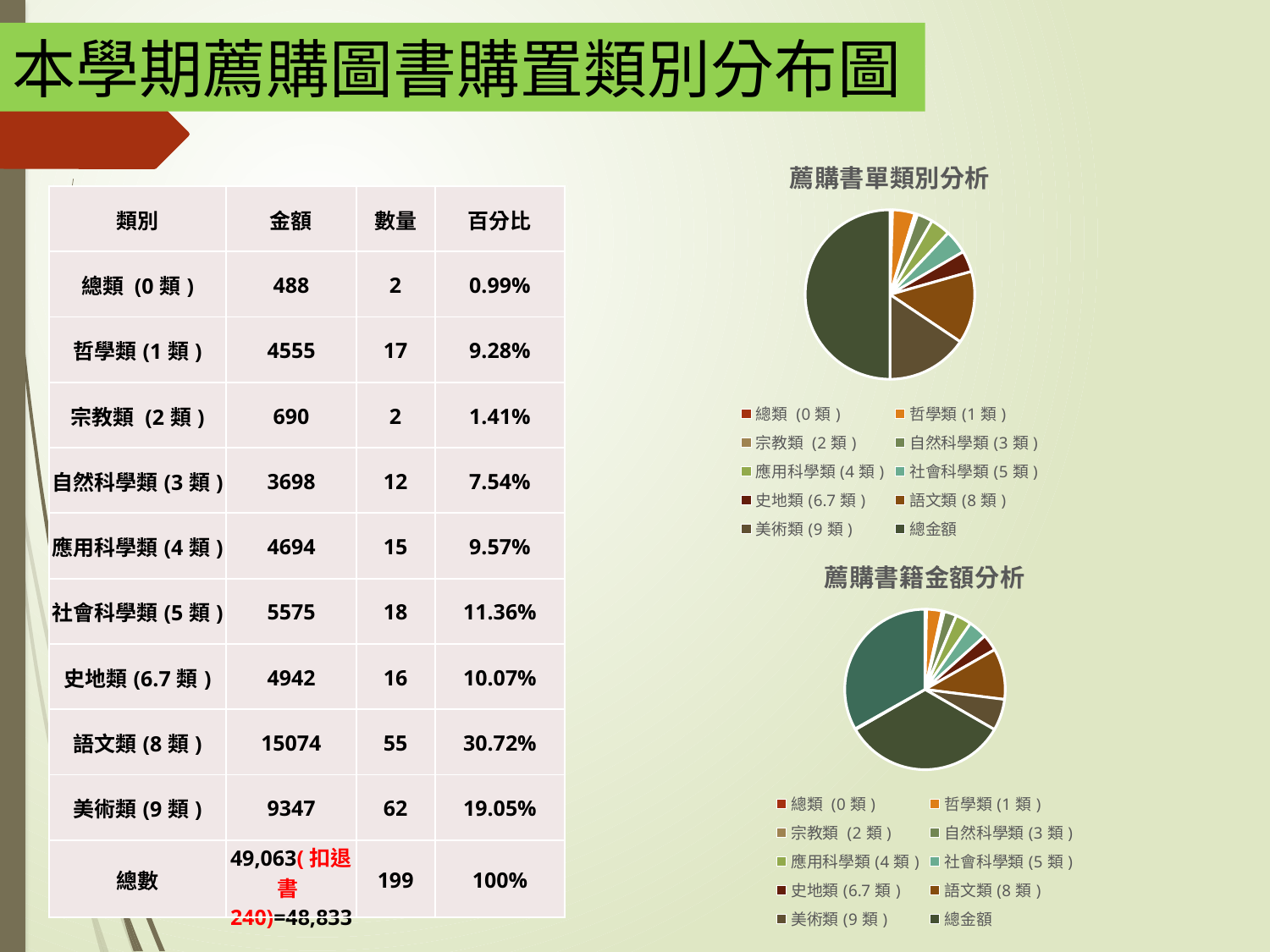
In the chart titled 薦購書單類別分析, which legend entry corresponds to the largest slice? 總金額 What is the title of the lower chart on the slide? 薦購書籍金額分析 What kind of chart is the chart titled 薦購書籍金額分析? pie chart How many charts are shown on the slide? 2 In the chart titled 薦購書單類別分析, which slice is larger: 語文類 (8 類) or 哲學類 (1 類)? 語文類 (8 類) How many entries does the legend of the chart titled 薦購書單類別分析 list? 10 In the chart titled 薦購書籍金額分析, which slice is larger: 社會科學類 (5 類) or 哲學類 (1 類)? 社會科學類 (5 類) How many entries does the legend of the chart titled 薦購書籍金額分析 list? 10 What kind of chart is the chart titled 薦購書單類別分析? pie chart What is the title of the upper chart on the slide? 薦購書單類別分析 In the chart titled 薦購書籍金額分析, which legend entry corresponds to the largest slice? 總金額